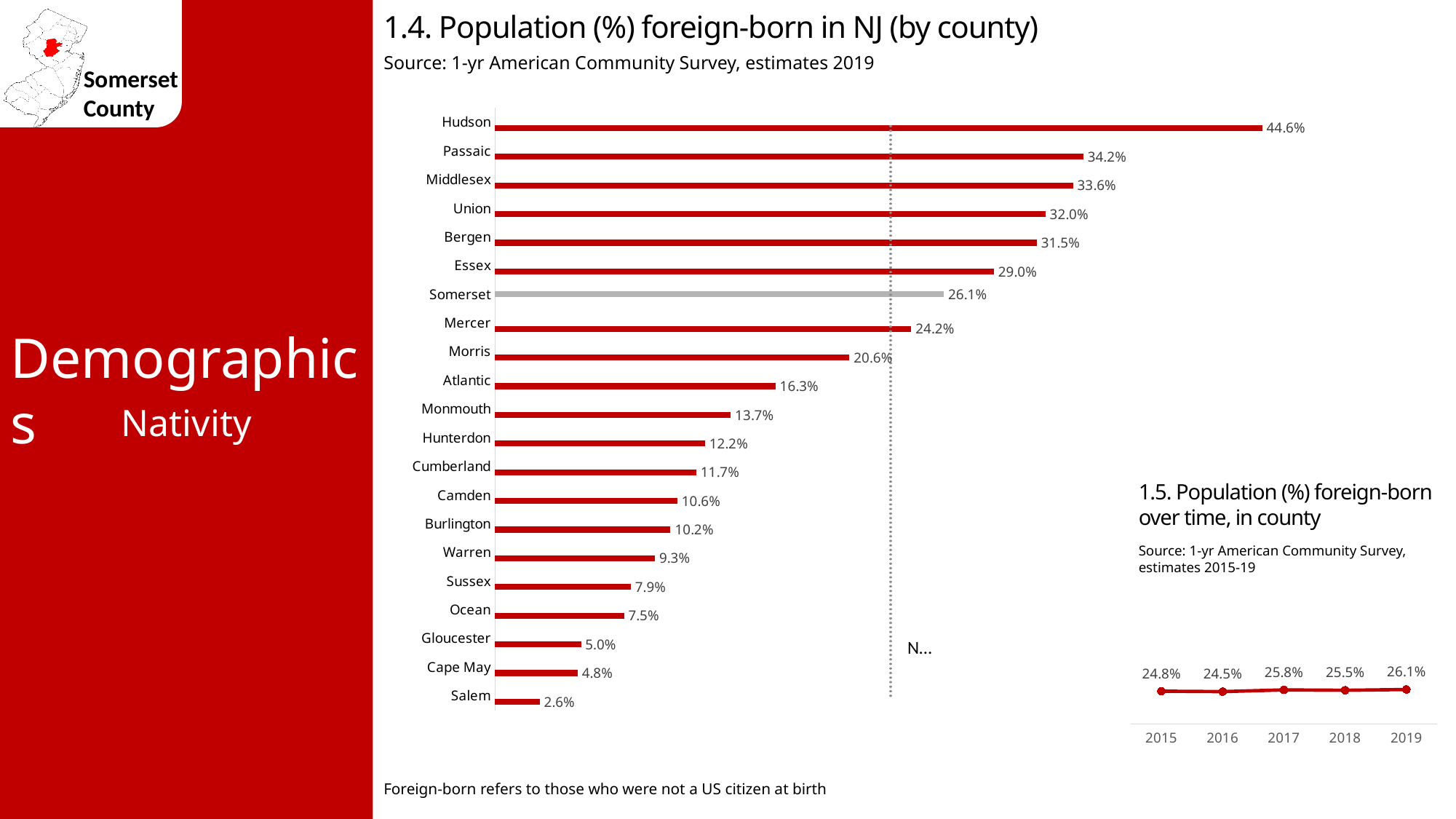
In the chart '1.4. Population (%) foreign-born in NJ (by county)', which bar is coloured grey instead of red? Somerset In the chart '1.4. Population (%) foreign-born in NJ (by county)', which is larger, Bergen or Essex? Bergen In the chart '1.5. Population (%) foreign-born over time, in county', which year has the lowest value? 2016 In the chart '1.4. Population (%) foreign-born in NJ (by county)', what is the difference between Hudson and Passaic? 10.4% In the chart '1.5. Population (%) foreign-born over time, in county', what is the value for 2017? 25.8% In the chart '1.4. Population (%) foreign-born in NJ (by county)', what is the value for Mercer? 24.2% In the chart '1.4. Population (%) foreign-born in NJ (by county)', which county has the highest value? Hudson What kind of chart is '1.4. Population (%) foreign-born in NJ (by county)'? Bar chart In the chart '1.4. Population (%) foreign-born in NJ (by county)', what is the value for Somerset? 26.1% In the chart '1.4. Population (%) foreign-born in NJ (by county)', which county has the lowest value? Salem In the chart '1.5. Population (%) foreign-born over time, in county', how many data points are plotted? 5 In the chart '1.4. Population (%) foreign-born in NJ (by county)', how many counties are shown? 21